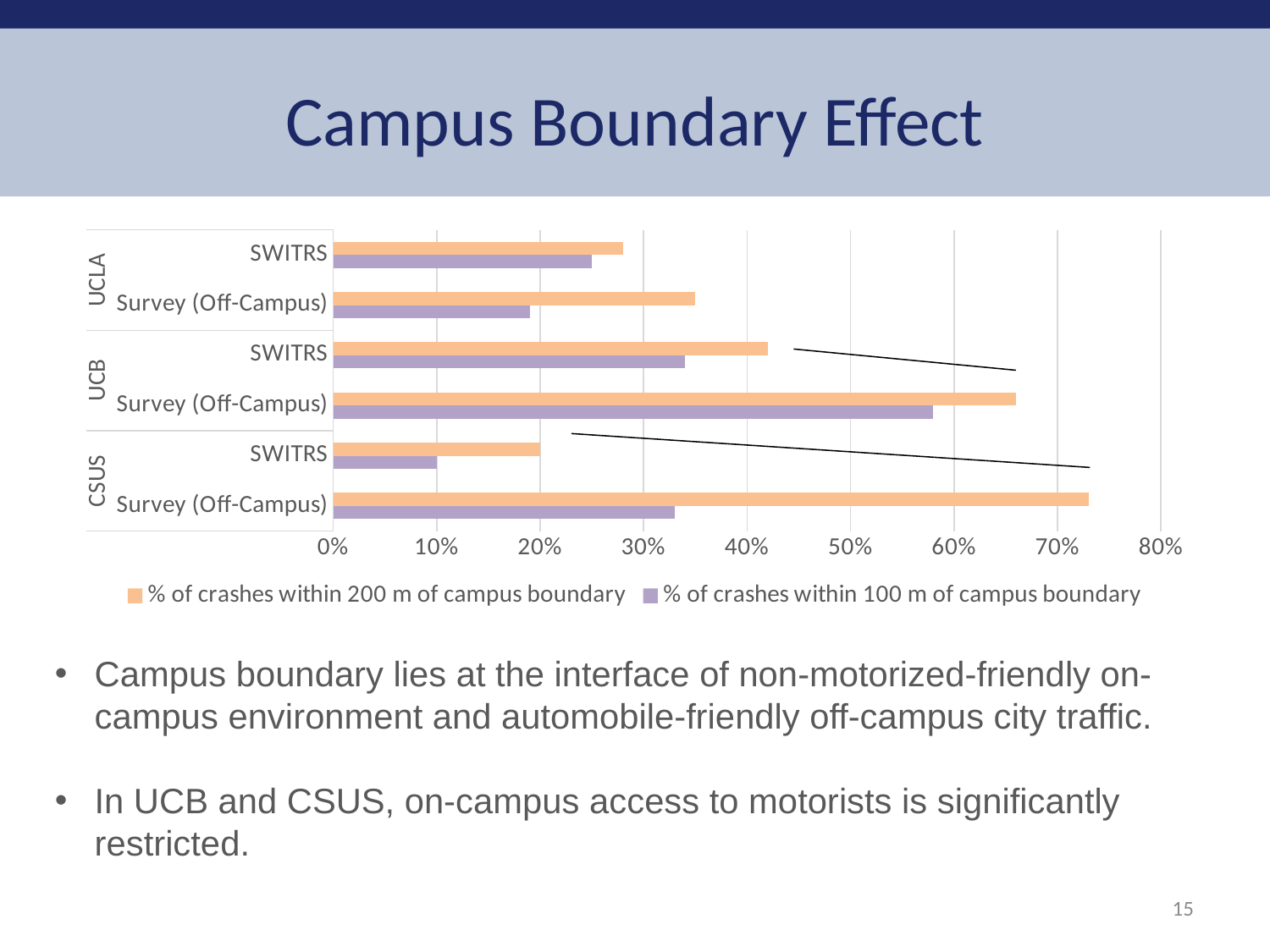
Is the value for CSUS Survey (Off-Campus) within 200 m of campus boundary greater or less than 60%? greater How many series does the legend list? 2 Which category has the lowest value for % of crashes within 100 m of campus boundary? CSUS SWITRS Which category has the highest value for % of crashes within 100 m of campus boundary? UCB Survey (Off-Campus) How many campuses are shown on the chart? 3 Is the value for CSUS SWITRS within 100 m of campus boundary greater or less than 20%? less Is the value for UCB Survey (Off-Campus) within 200 m of campus boundary greater or less than 60%? greater What colour are the bars for % of crashes within 100 m of campus boundary? purple What kind of chart is shown on the slide? bar chart Which category has the highest value for % of crashes within 200 m of campus boundary? CSUS Survey (Off-Campus) For CSUS Survey (Off-Campus), which series has the larger value: within 200 m or within 100 m of campus boundary? % of crashes within 200 m of campus boundary Which is larger for UCB: the SWITRS value or the Survey (Off-Campus) value for % of crashes within 200 m of campus boundary? Survey (Off-Campus)